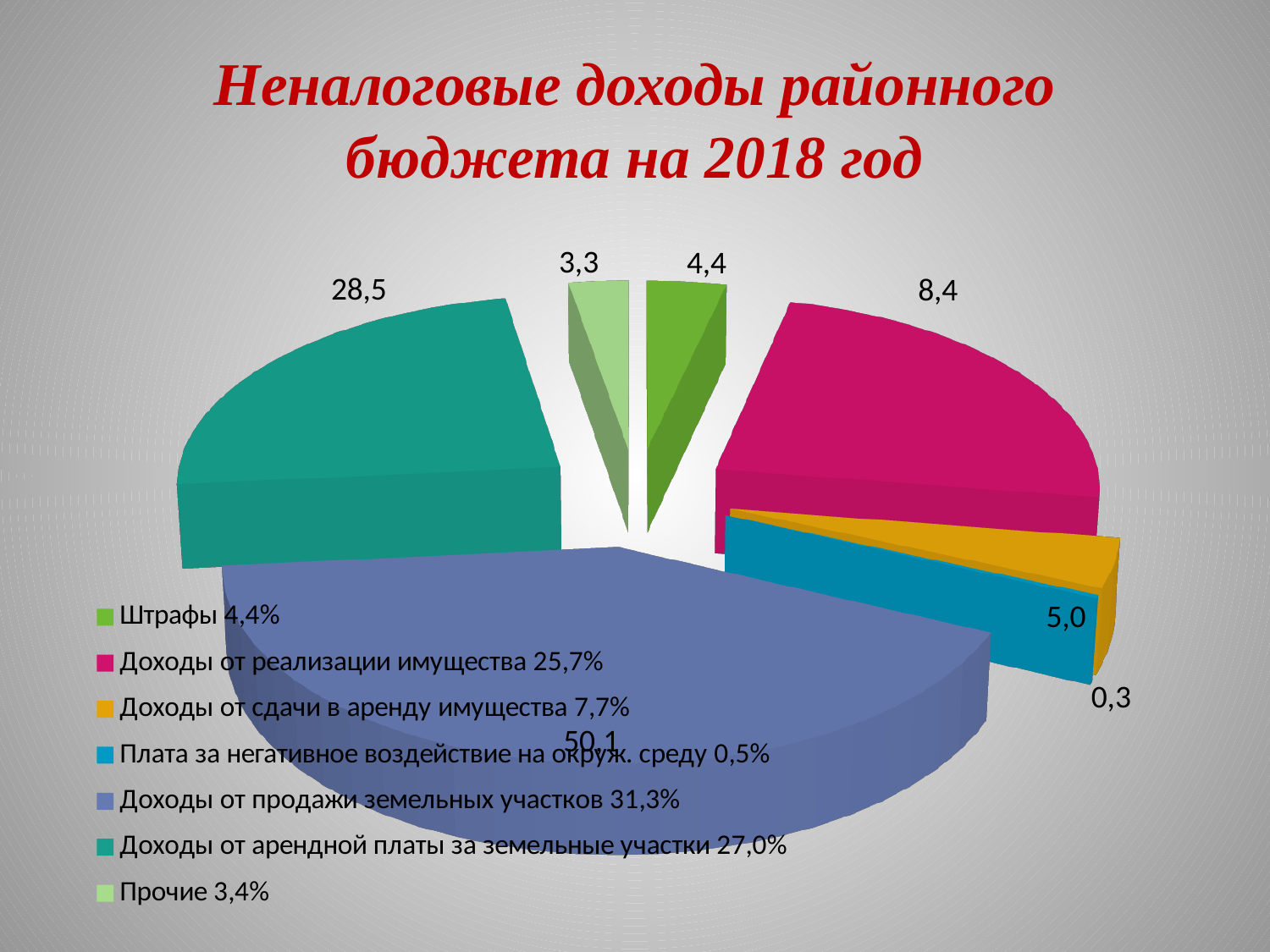
What is the difference between the labelled values for Доходы от продажи земельных участков and Доходы от арендной платы за земельные участки? 21,6 Which category has the largest slice of the pie? Доходы от продажи земельных участков According to the legend, what share of the pie is Доходы от реализации имущества? 25,7% Which is larger, the labelled value for Штрафы or for Прочие? Штрафы What value is labelled on the slice for Штрафы? 4,4 How many categories does the legend list? 7 What value is labelled on the slice for Доходы от продажи земельных участков? 50,1 What value is labelled on the slice for Прочие? 3,3 What is the title of the chart? Неналоговые доходы районного бюджета на 2018 год Which category has the smallest slice of the pie? Плата за негативное воздействие на окруж. среду What kind of chart is shown on the slide? pie chart What value is labelled on the slice for Доходы от арендной платы за земельные участки? 28,5